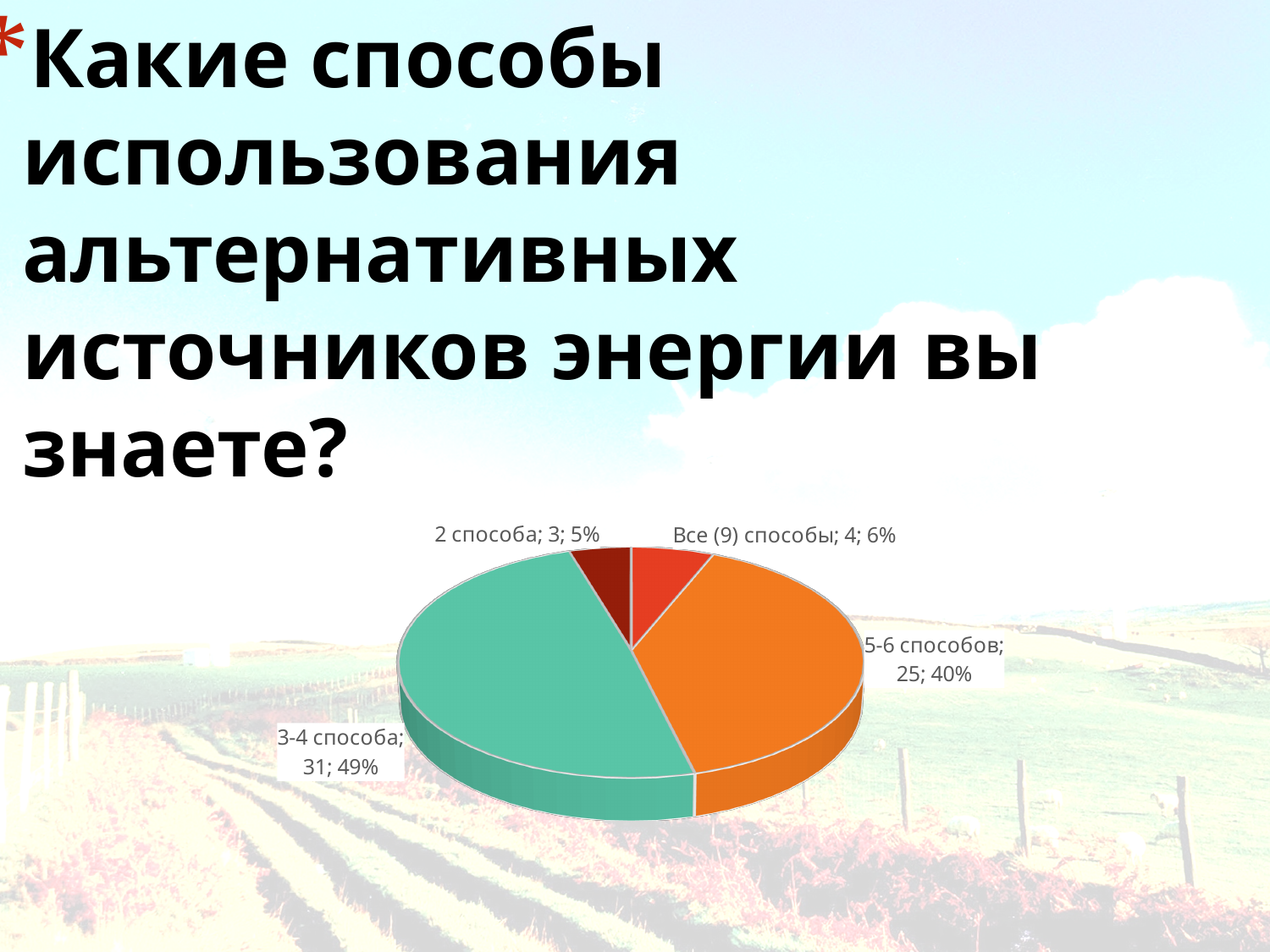
What is the total of all the values shown in the pie chart? 63 Which category has the smallest slice? 2 способа What is the difference between the values for "3-4 способа" and "5-6 способов"? 6 Which category has the largest slice? 3-4 способа Which is larger, the value for "Все (9) способы" or the value for "2 способа"? Все (9) способы What kind of chart is shown on the slide? pie chart What is the value for "3-4 способа"? 31 What is the value for "2 способа"? 3 What colour is the "3-4 способа" slice? green What percentage share does "5-6 способов" have? 40% What percentage share does "Все (9) способы" have? 6% How many slices does the pie chart have? 4